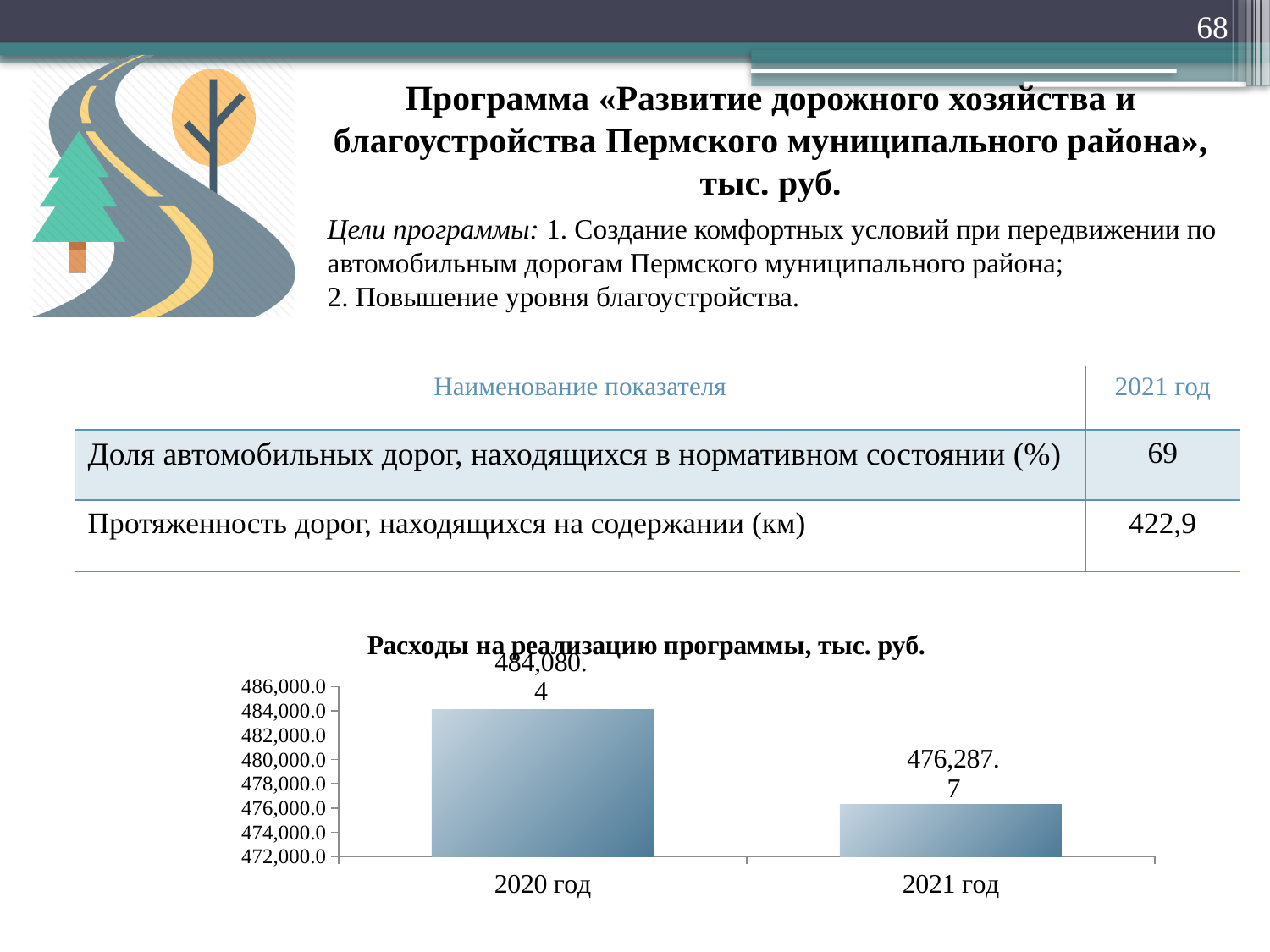
Do the values rise or fall from 2020 год to 2021 год? fall What is the title of the chart? Расходы на реализацию программы, тыс. руб. Which year has the highest value? 2020 год What is the value for 2020 год? 484,080.4 How many bars (categories) does the chart show? 2 What is the difference between the values for 2020 год and 2021 год? 7,792.7 Is the value for 2021 год greater or less than 478,000.0? less Which year has the lowest value? 2021 год What type of chart is shown on the slide? bar chart What is the value for 2021 год? 476,287.7 Is the value for 2020 год greater or less than 482,000.0? greater Which is larger, the value for 2020 год or for 2021 год? 2020 год